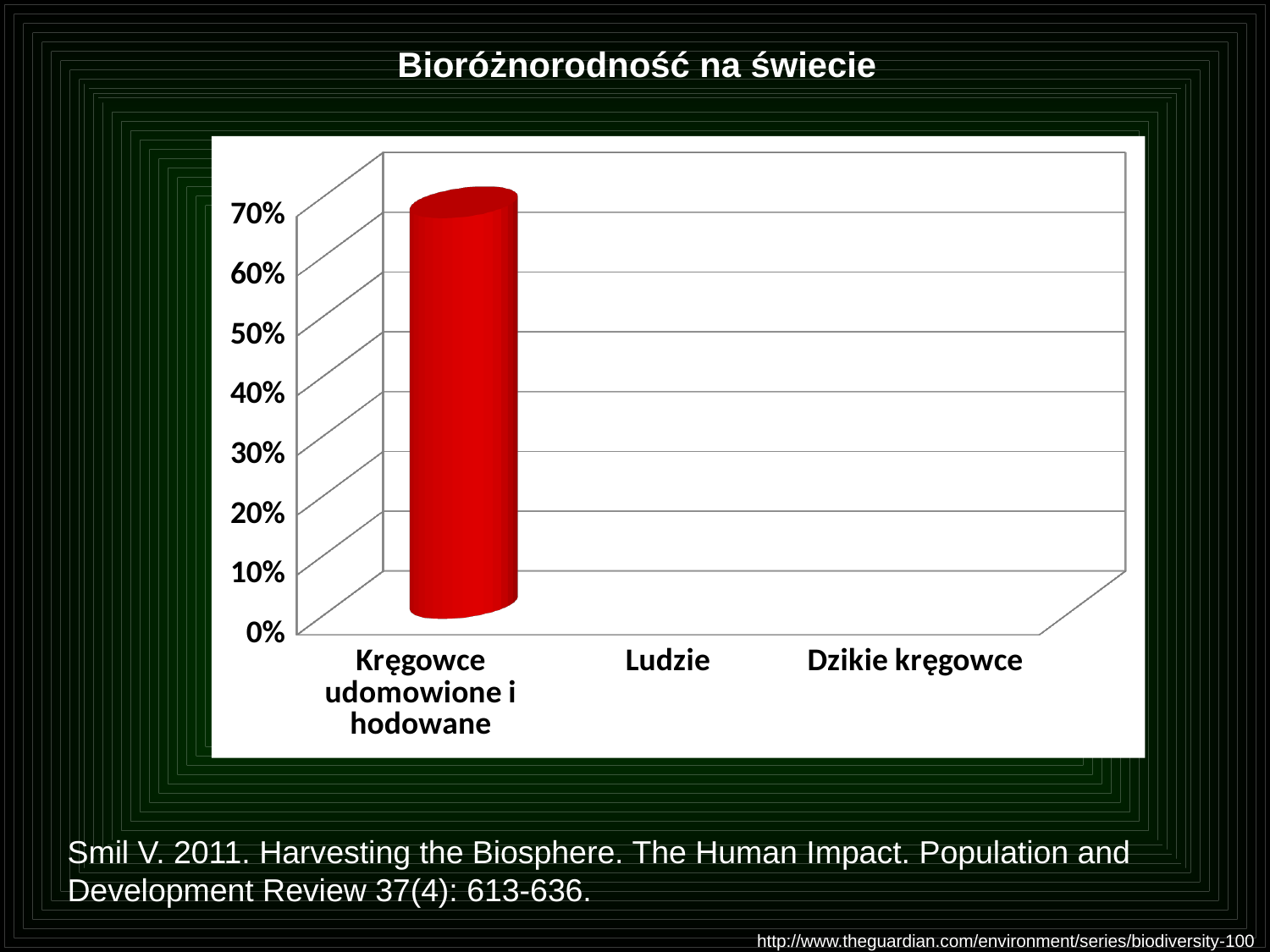
What colour is the bar for Kręgowce udomowione i hodowane? red Which category is labelled in the middle of the x axis? Ludzie Is the value for Kręgowce udomowione i hodowane greater or less than 60%? greater What is the title of the chart? Bioróżnorodność na świecie Is the value for Kręgowce udomowione i hodowane greater or less than 50%? greater Which category has the tallest bar in the chart? Kręgowce udomowione i hodowane What kind of chart is shown on the slide? bar chart How many categories are labelled on the x axis of the chart? 3